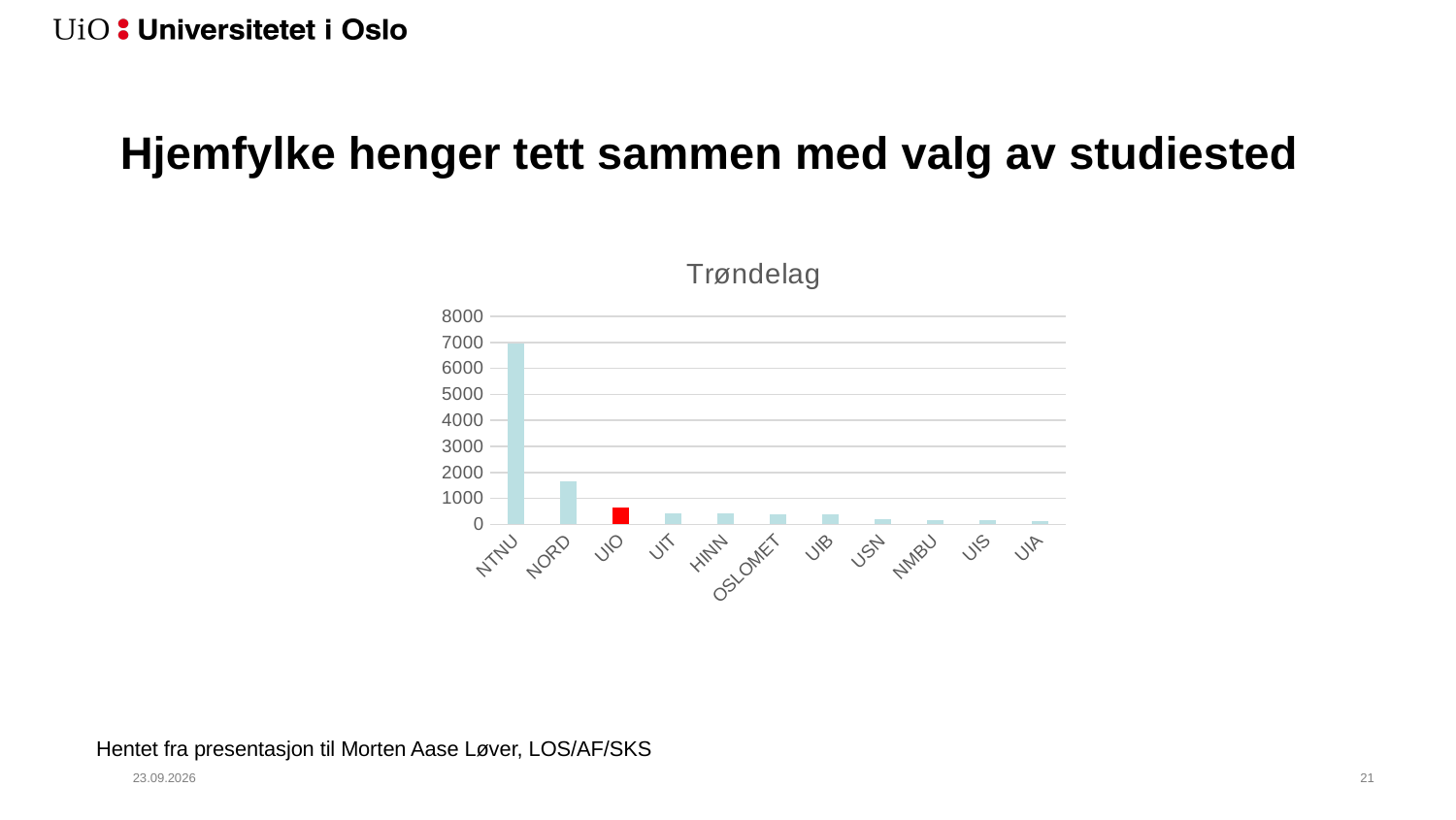
Is the value for NTNU greater or less than 6000? greater Which is larger, the value for NTNU or the value for NORD? NTNU What is the title of the chart? Trøndelag Do the values generally rise or fall moving from left to right along the x axis? fall What kind of chart is shown on the slide? bar chart Is the value for NORD greater or less than 1000? greater Is the value for UIO greater or less than 1000? less Which category has the highest value in the chart? NTNU Which is larger, the value for NORD or the value for UIO? NORD Which category's bar is highlighted in red? UIO How many categories are shown on the x axis of the chart? 11